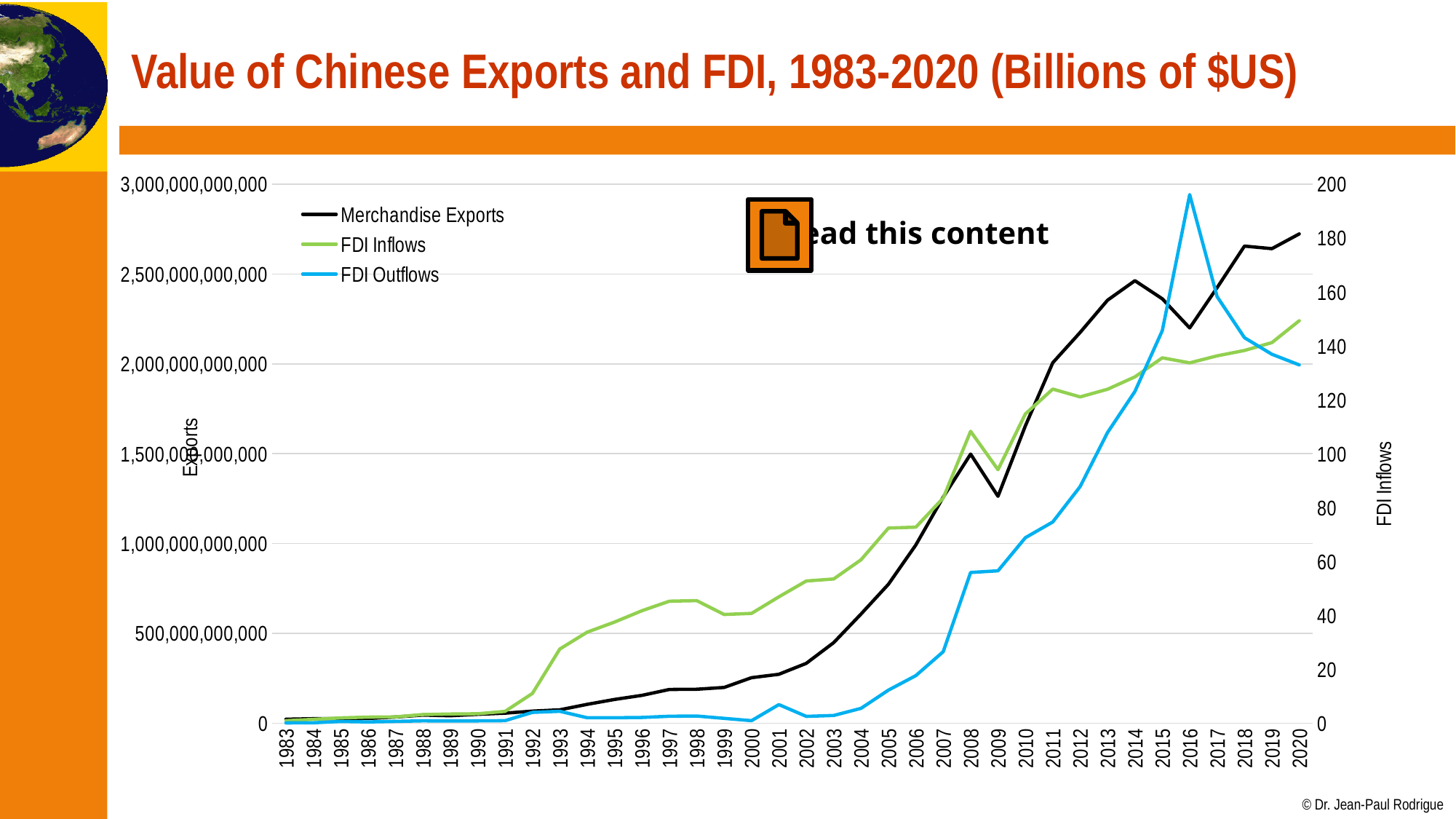
What kind of chart is shown on the slide? Line chart Is the value for Merchandise Exports in 2020 greater or less than 2,500,000,000,000? greater Is the value for Merchandise Exports in 2000 greater or less than 500,000,000,000? less How many years are plotted along the x axis? 38 What colour is the FDI Outflows line in the legend? Blue In which year does the FDI Outflows series reach its highest value? 2016 Does the Merchandise Exports series generally rise or fall from 1983 to 2020? Rise How many series does the legend list? 3 Is the value for Merchandise Exports in 2009 greater or less than 1,500,000,000,000? less In 2020, which is higher, FDI Inflows or FDI Outflows? FDI Inflows In 2016, which is higher, FDI Inflows or FDI Outflows? FDI Outflows